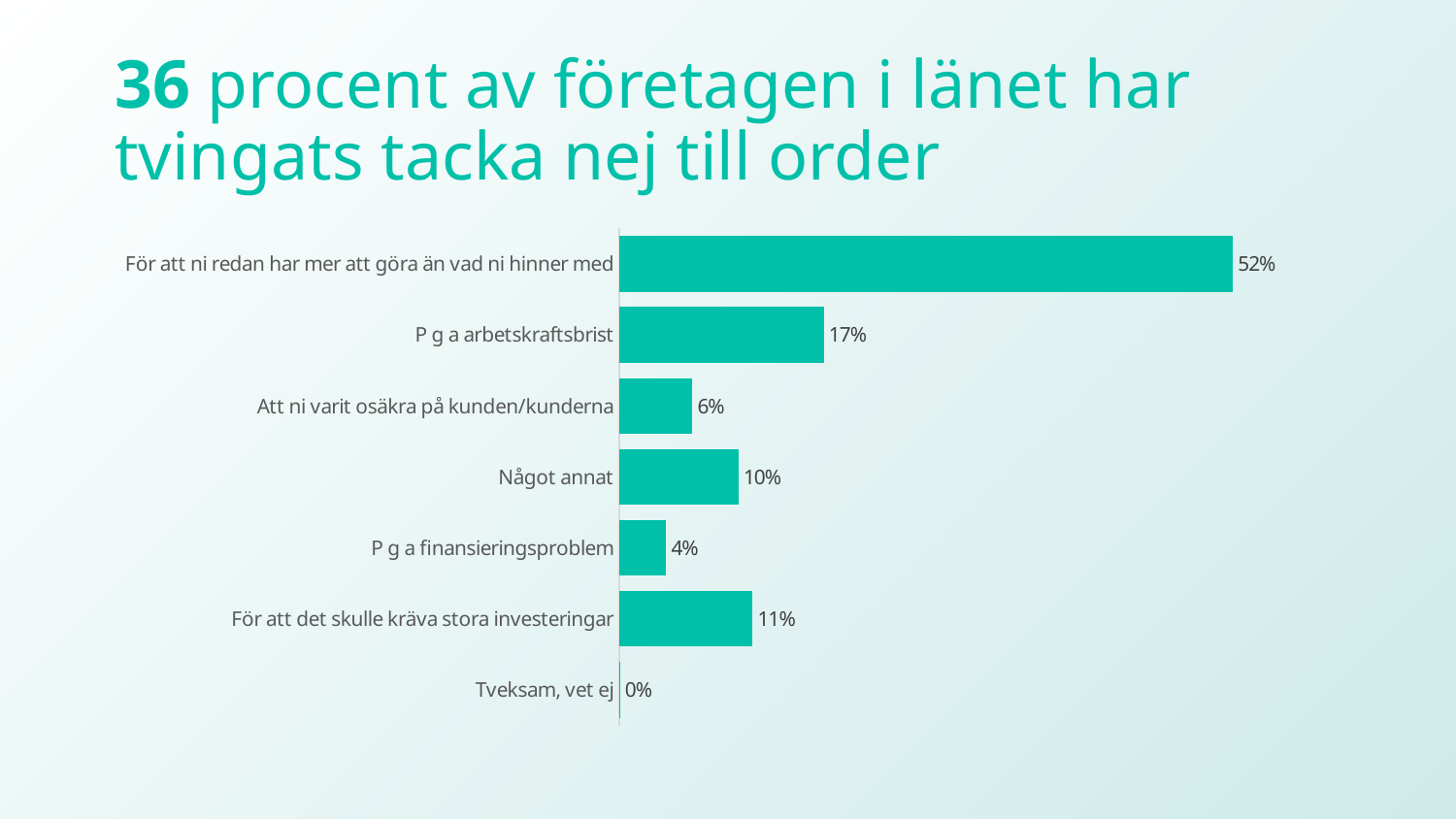
Which category has the highest value? För att ni redan har mer att göra än vad ni hinner med What is the difference between the values for "För att ni redan har mer att göra än vad ni hinner med" and "P g a arbetskraftsbrist"? 35% What is the value for "P g a arbetskraftsbrist"? 17% What is the value for "För att det skulle kräva stora investeringar"? 11% How many categories are shown in the chart? 7 What is the difference between the values for "Att ni varit osäkra på kunden/kunderna" and "P g a finansieringsproblem"? 2% Which category has the lowest value? Tveksam, vet ej What kind of chart is shown on the slide? Bar chart What is the value for "Tveksam, vet ej"? 0% Which is larger, the value for "Något annat" or the value for "För att det skulle kräva stora investeringar"? För att det skulle kräva stora investeringar What is the value for "Något annat"? 10% What colour are the bars in the chart? Teal